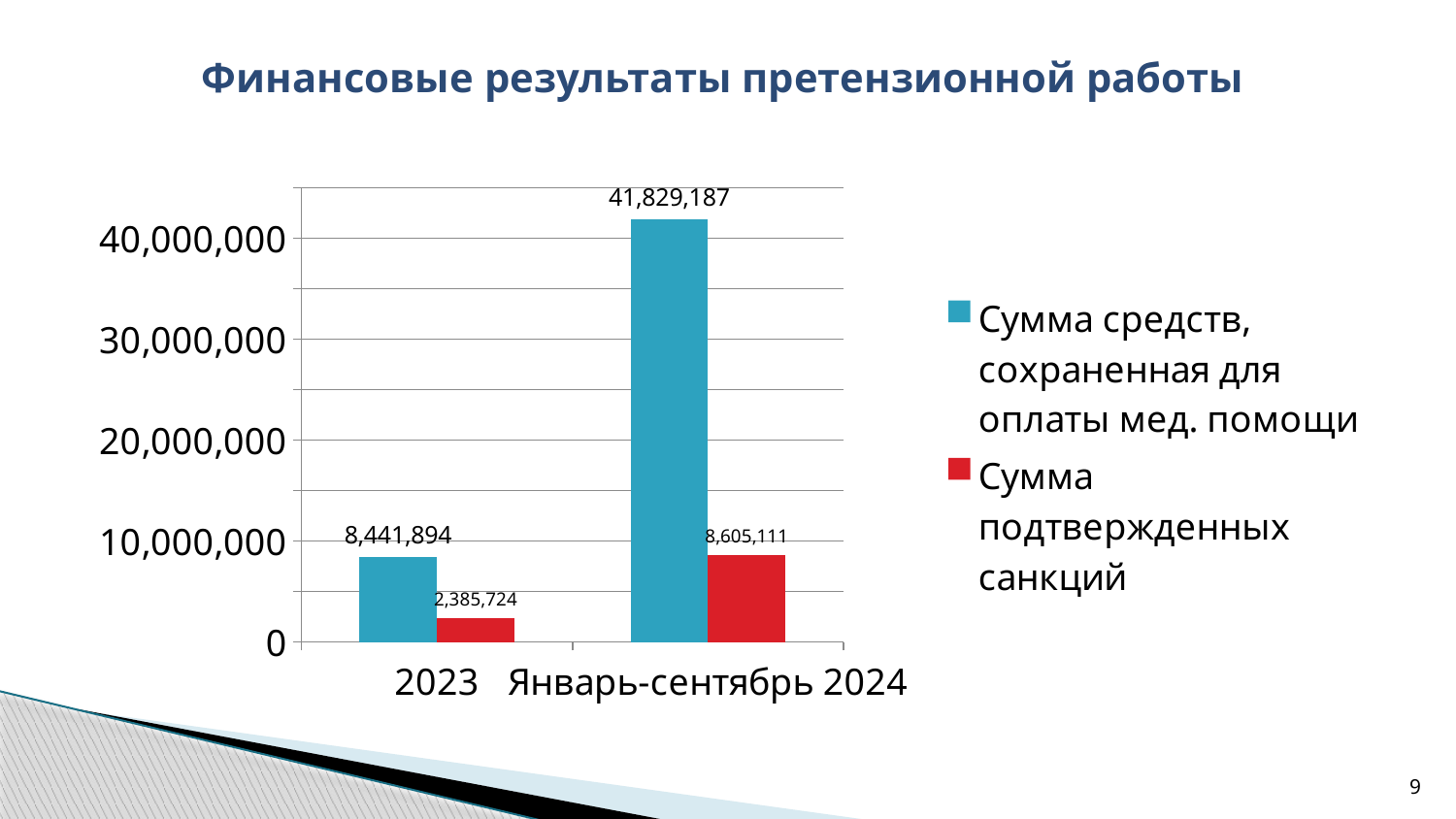
How many series does the legend list? 2 What is the difference between 'Сумма средств, сохраненная для оплаты мед. помощи' for Январь-сентябрь 2024 and for 2023? 33,387,293 Which category has the lowest value for 'Сумма подтвержденных санкций'? 2023 What kind of chart is shown on the slide? bar chart What is the value of 'Сумма подтвержденных санкций' for 2023? 2,385,724 Which category has the highest value for 'Сумма средств, сохраненная для оплаты мед. помощи'? Январь-сентябрь 2024 What is the value of 'Сумма средств, сохраненная для оплаты мед. помощи' for 2023? 8,441,894 What is the difference between 'Сумма подтвержденных санкций' for Январь-сентябрь 2024 and for 2023? 6,219,387 Which is larger in 2023: 'Сумма средств, сохраненная для оплаты мед. помощи' or 'Сумма подтвержденных санкций'? Сумма средств, сохраненная для оплаты мед. помощи What is the value of 'Сумма подтвержденных санкций' for Январь-сентябрь 2024? 8,605,111 Is the value for 'Сумма средств, сохраненная для оплаты мед. помощи' in Январь-сентябрь 2024 greater or less than 40,000,000? greater What is the value of 'Сумма средств, сохраненная для оплаты мед. помощи' for Январь-сентябрь 2024? 41,829,187